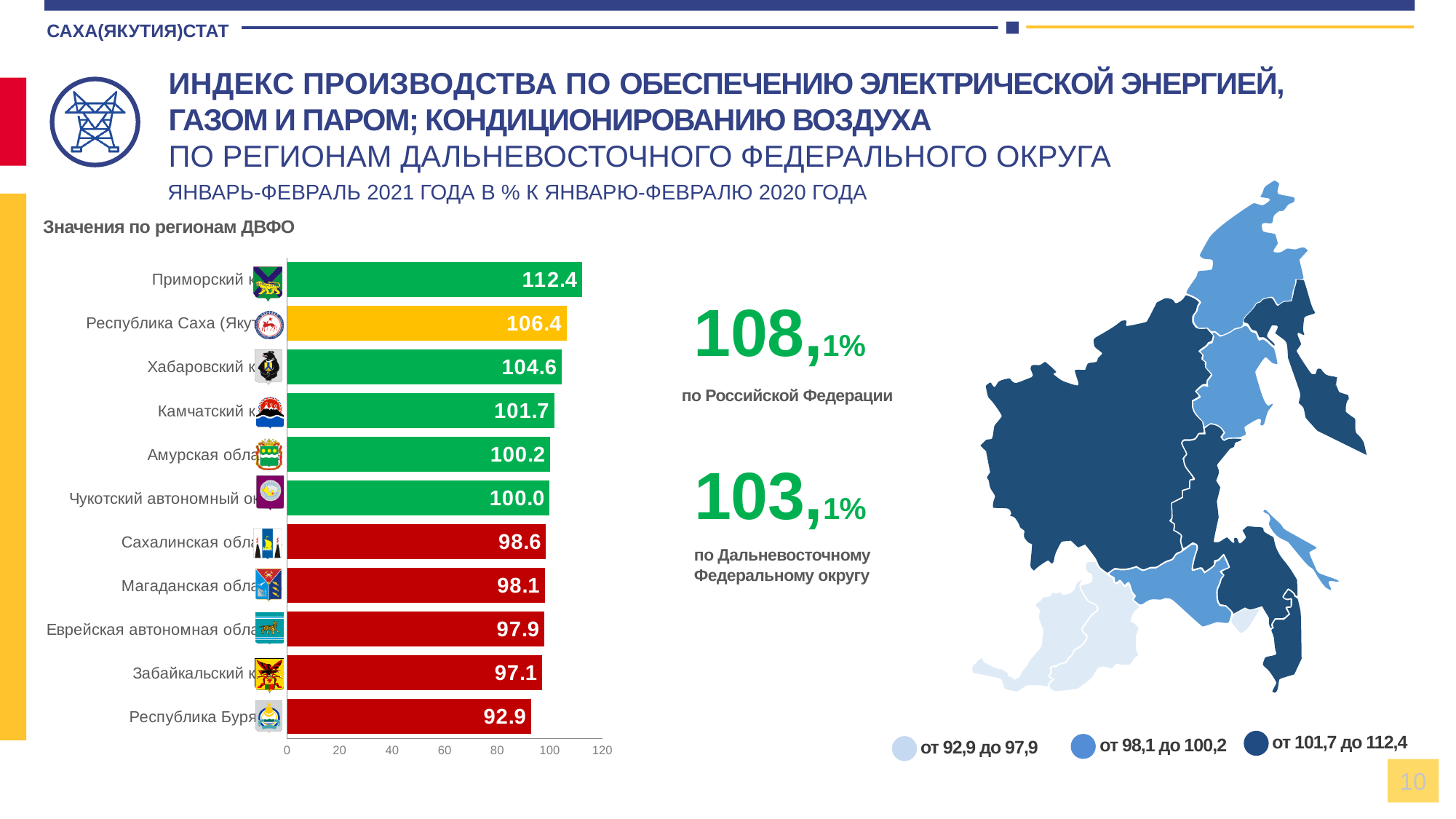
What is the value for Приморский край in the bar chart? 112.4 What colour is the bar for Республика Саха (Якутия)? yellow What is the value for Республика Саха (Якутия) in the bar chart? 106.4 What is the value for Чукотский автономный округ in the bar chart? 100.0 What is the index value shown for the Russian Federation (по Российской Федерации)? 108,1% What is the difference between the values for Приморский край and Республика Бурятия? 19.5 How many regions are shown in the bar chart? 11 Which has a larger value, Хабаровский край or Камчатский край? Хабаровский край Which region has the highest value in the bar chart? Приморский край What kind of chart is used to show the values by region? bar chart What is the value for Сахалинская область in the bar chart? 98.6 Which region has the lowest value in the bar chart? Республика Бурятия